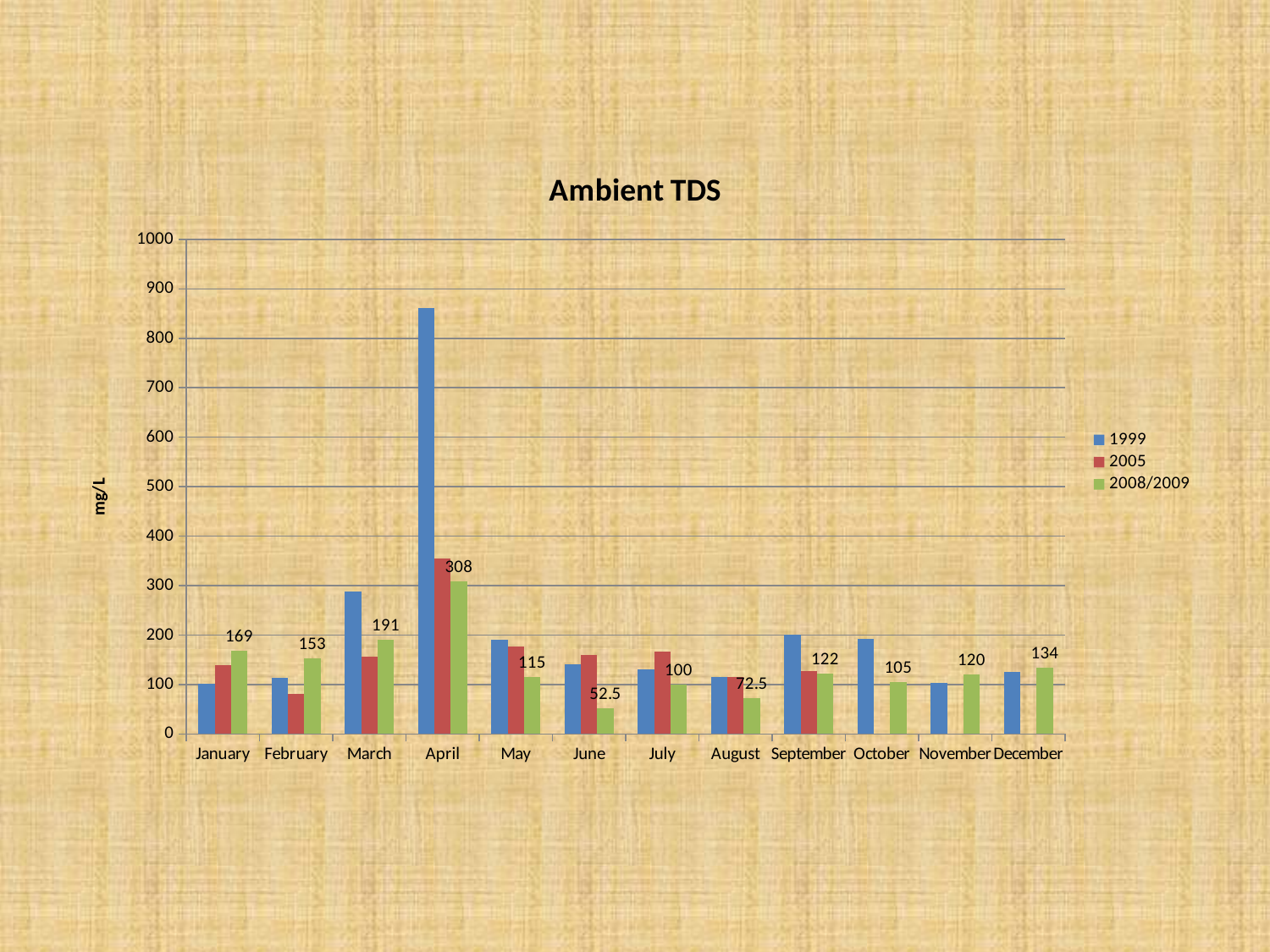
Which is larger, the 2008/2009 value for January or for February? January What is the 2008/2009 value for April? 308 Is the 2005 value for February greater or less than 100? less What is the 2008/2009 value for June? 52.5 Which month has the lowest 2008/2009 value? June How many months are shown on the x axis? 12 Which month has the highest 2008/2009 value? April How many series does the legend list? 3 What is the difference between the 2008/2009 values for April and March? 117 What kind of chart is shown? bar chart Is the 1999 value for April greater or less than 800? greater What is the 2008/2009 value for December? 134